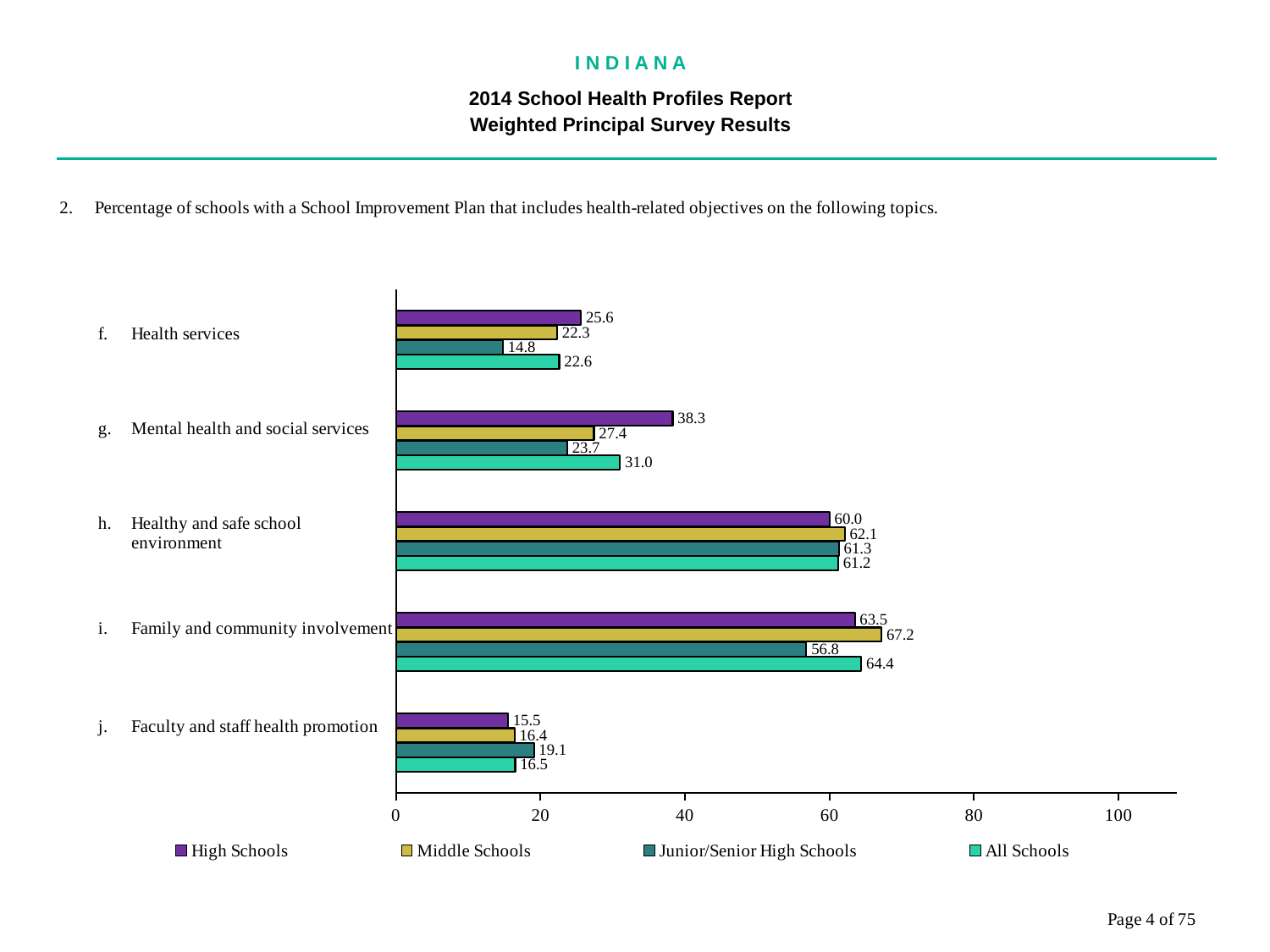
Which series is shown in purple in the legend? High Schools What kind of chart is shown on the slide? Bar chart Which topic has the highest value for Middle Schools? Family and community involvement How many series does the legend list? 4 What is the difference between the High Schools and Middle Schools values for Mental health and social services? 10.9 Which topic has the lowest value for High Schools? Faculty and staff health promotion What is the value for High Schools for Health services? 25.6 What is the value for All Schools for Family and community involvement? 64.4 Which is larger for Family and community involvement: the Middle Schools value or the Junior/Senior High Schools value? Middle Schools What is the value for Junior/Senior High Schools for Mental health and social services? 23.7 What is the value for Middle Schools for Faculty and staff health promotion? 16.4 How many topics are shown on the chart? 5